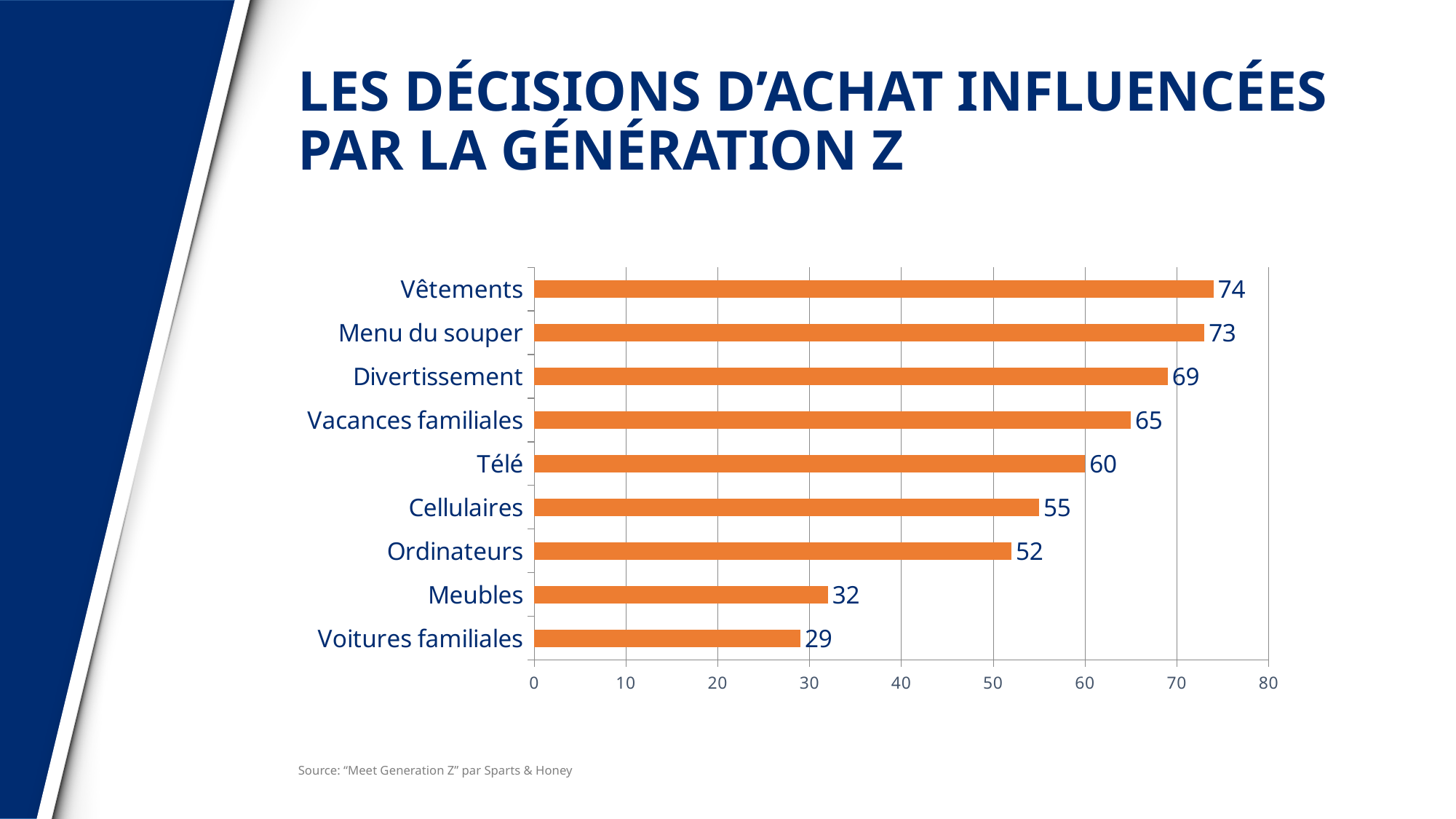
Which category has the lowest value? Voitures familiales What is the value for Télé? 60 What is the value for Vêtements? 74 How many categories are shown in the chart? 9 What kind of chart is shown on the slide? Bar chart What is the difference between the values for Cellulaires and Voitures familiales? 26 Is the value for Ordinateurs greater or less than 40? greater Which is larger, the value for Vacances familiales or the value for Cellulaires? Vacances familiales What is the value for Meubles? 32 Which category has the highest value? Vêtements What is the title of the slide? LES DÉCISIONS D'ACHAT INFLUENCÉES PAR LA GÉNÉRATION Z What is the difference between the values for Divertissement and Ordinateurs? 17